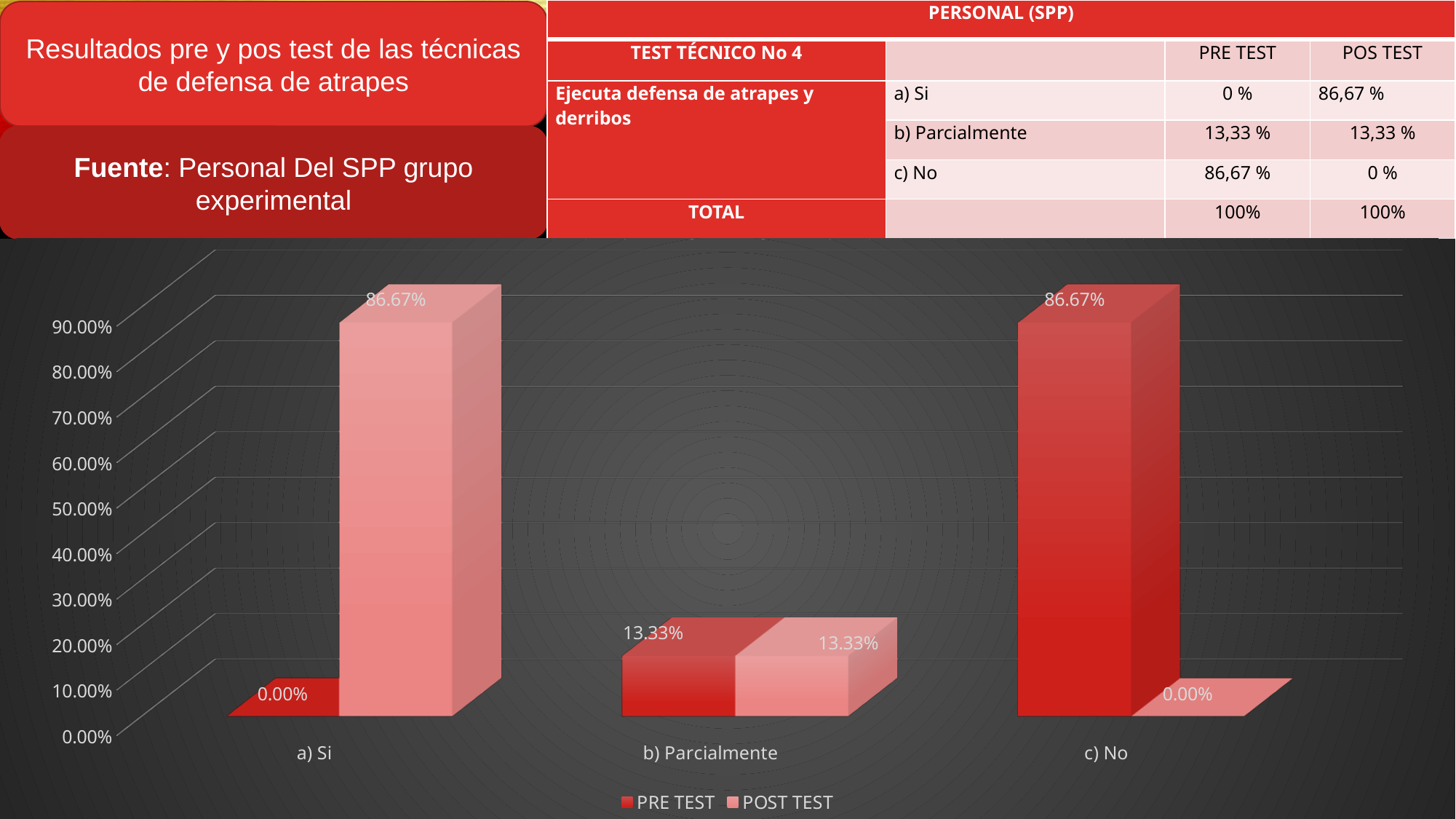
How many series does the chart legend list? 2 How many categories are shown on the x axis of the chart? 3 Which is larger for c) No: the PRE TEST value or the POST TEST value? PRE TEST Which category has the highest PRE TEST value? c) No Which category has the highest POST TEST value? a) Si What kind of chart is shown on the slide? Bar chart What is the POST TEST value for c) No? 0.00% What is the PRE TEST value for b) Parcialmente? 13.33% What is the POST TEST value for a) Si? 86.67% What is the difference between the POST TEST and PRE TEST values for a) Si? 86.67% What is the PRE TEST value for a) Si? 0.00% What is the PRE TEST value for c) No? 86.67%